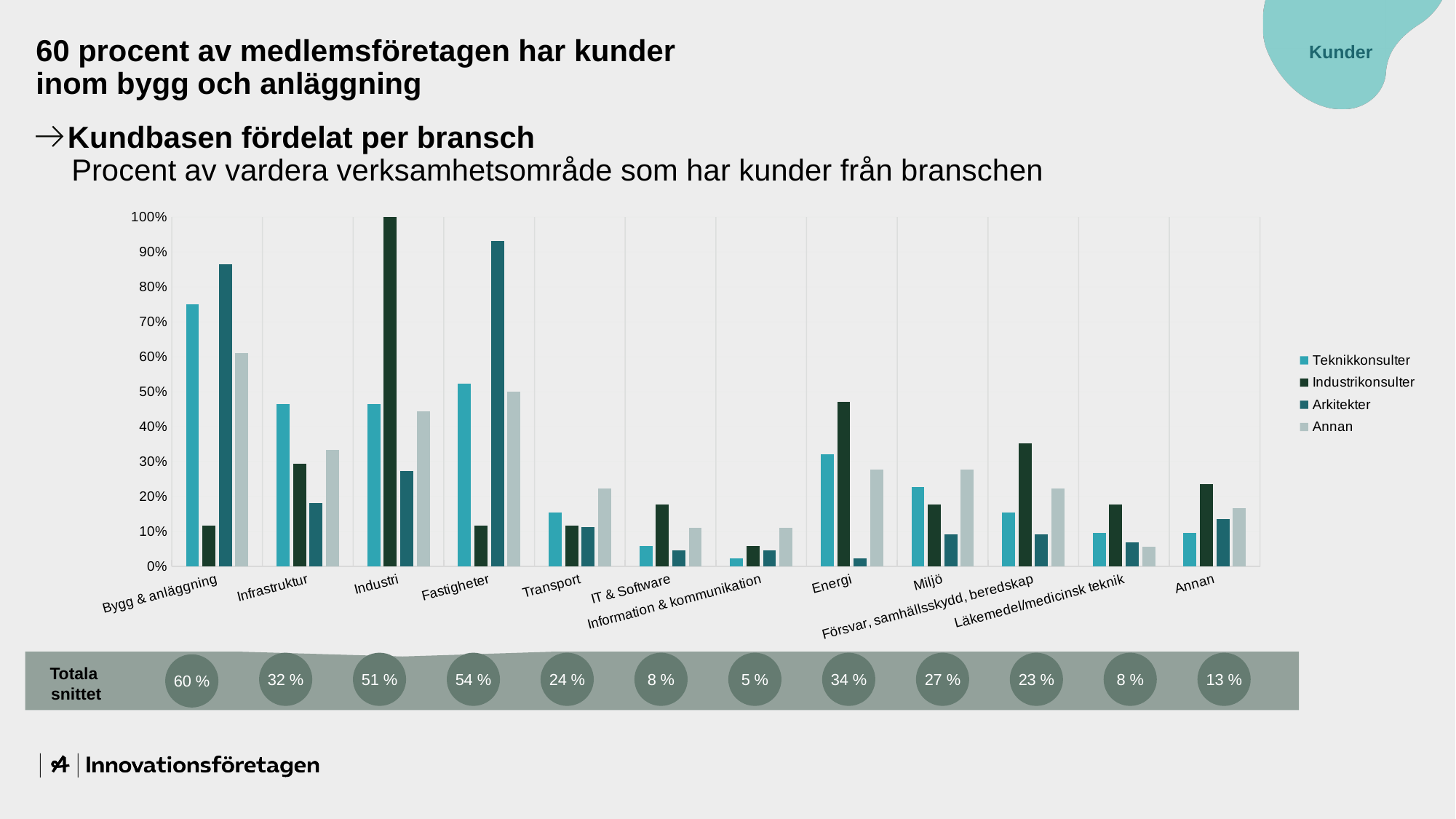
What is the 'Totala snittet' value for Bygg & anläggning? 60 % Is the value for Teknikkonsulter in Bygg & anläggning greater or less than 70%? greater What kind of chart is shown on the slide? bar chart What is the 'Totala snittet' value for Information & kommunikation? 5 % How many industry categories are shown on the x axis? 12 What is the difference between the 'Totala snittet' values for Bygg & anläggning and Infrastruktur? 28 percentage points Which has a higher 'Totala snittet' value, Energi or Miljö? Energi How many series does the legend list? 4 Is the value for Industrikonsulter in Fastigheter greater or less than 90%? less Which category has the highest 'Totala snittet' value? Bygg & anläggning What is the value for Industrikonsulter in the Industri category? 100% Which category has the lowest 'Totala snittet' value? Information & kommunikation